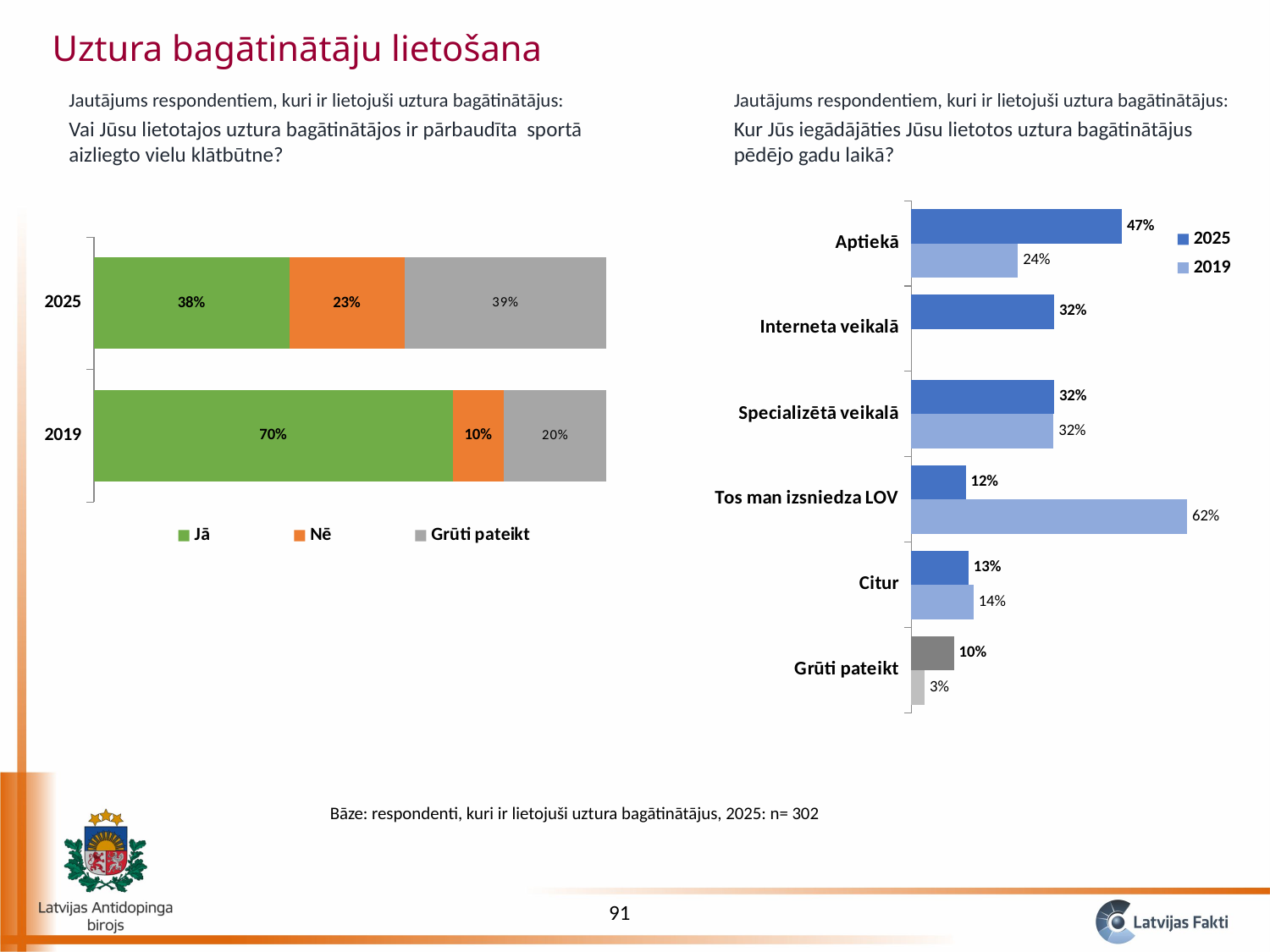
In the right chart, what is the 2025 value for "Aptiekā"? 47% In the right chart, what is the difference between the 2019 and 2025 values for "Tos man izsniedza LOV"? 50 percentage points In the left chart, what is the value for "Jā" in 2025? 38% What kind of chart is shown on the right side of the slide? bar chart In the right chart, is the 2025 value for "Citur" larger or smaller than its 2019 value? smaller In the left chart, how many series does the legend list? 3 In the left chart, what is the difference between the "Jā" values for 2019 and 2025? 32 percentage points In the left chart, what is the value for "Nē" in 2019? 10% In the right chart, which category has the highest 2025 value? Aptiekā In the right chart, what is the 2019 value for "Tos man izsniedza LOV"? 62% In the right chart, which category has the lowest 2019 value? Grūti pateikt In the left chart, what is the total of the stacked bar for 2025? 100%